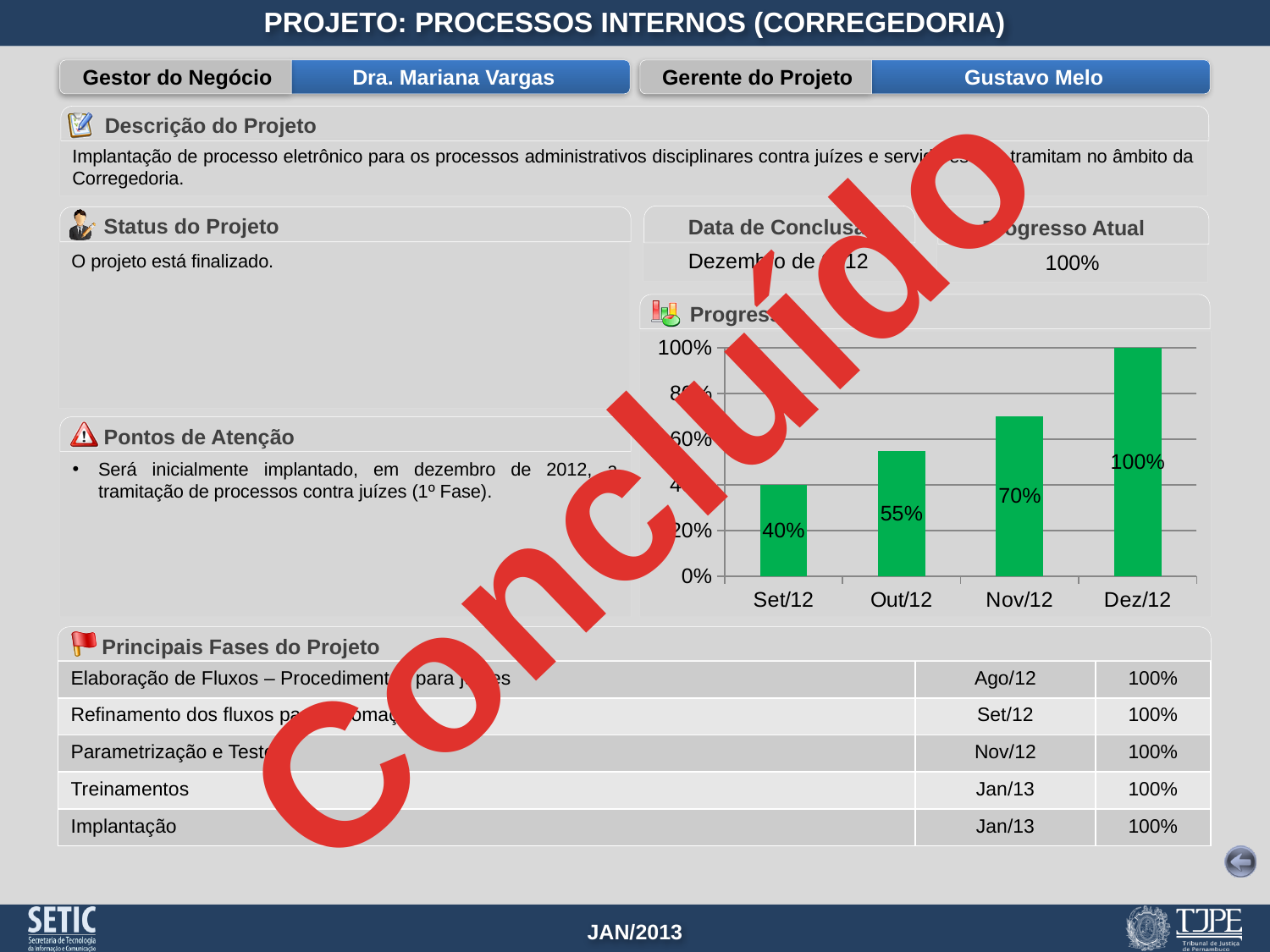
What is the difference between the values for Dez/12 and Nov/12 in the progress chart? 30% Which month has the lowest value in the progress chart? Set/12 What is the value for Nov/12 in the progress chart? 70% What kind of chart is the progress chart? Bar chart What is the value for Set/12 in the progress chart? 40% What is the value for Dez/12 in the progress chart? 100% Do the values in the progress chart rise or fall from Set/12 to Dez/12? Rise What is the difference between the values for Out/12 and Set/12 in the progress chart? 15% Which month has the highest value in the progress chart? Dez/12 What is the value for Out/12 in the progress chart? 55% How many months are plotted in the progress chart? 4 Which is larger in the progress chart, the value for Nov/12 or the value for Out/12? Nov/12